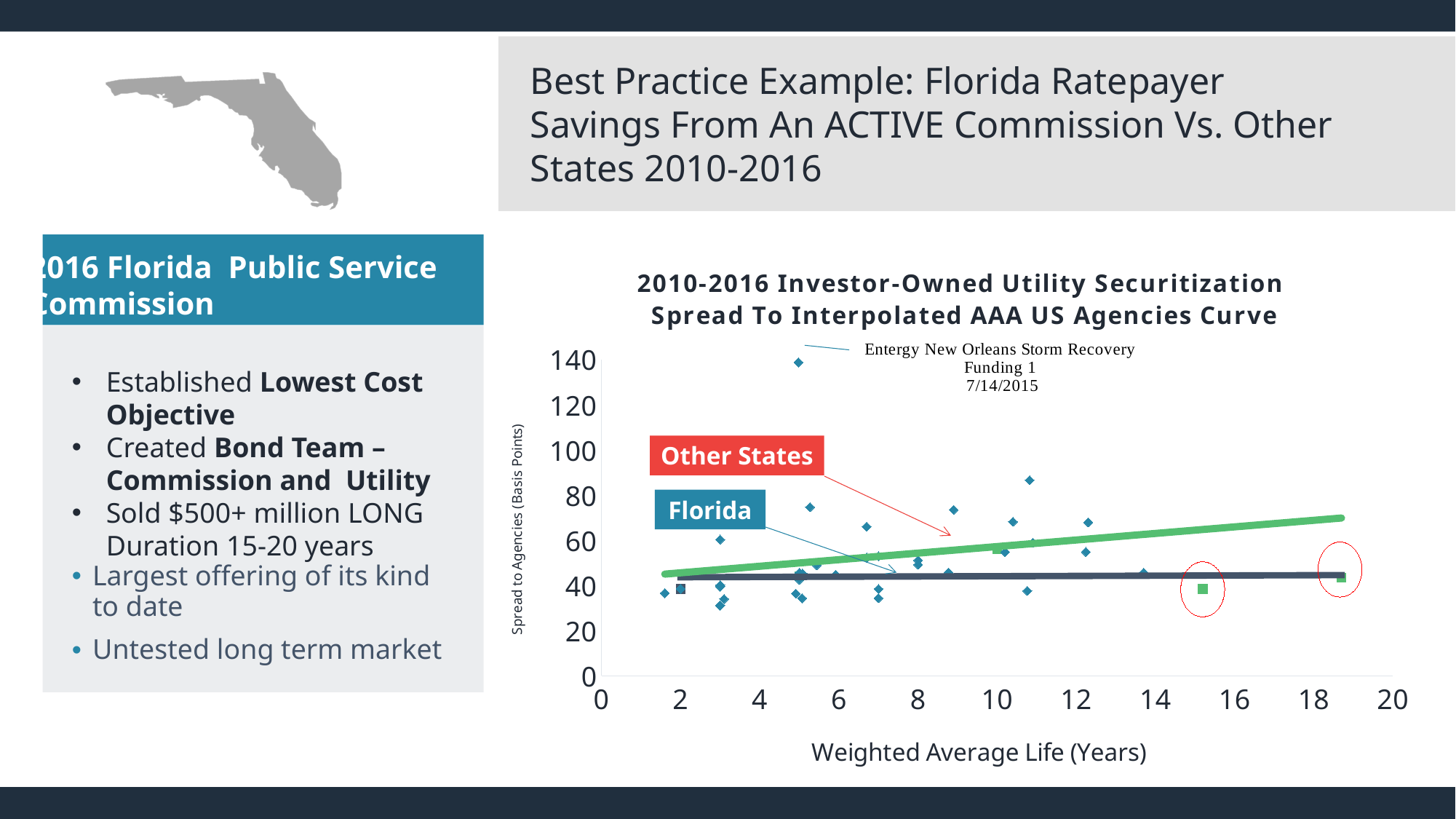
What is the highest value shown on the y axis? 140 Which issuance is annotated as the highest point on the chart? Entergy New Orleans Storm Recovery Funding 1 (7/14/2015) Is the spread for the circled Florida point near 15 years weighted average life greater or less than 60 basis points? less How many series are labeled on the chart? 2 At 18 years weighted average life, which trend line is higher, Other States or Florida? Other States Which series contains the highest plotted point on the chart? Other States Does the Other States trend line rise or fall as weighted average life increases? rises Is the spread for the circled Florida point near 19 years weighted average life greater or less than 60 basis points? less What kind of chart is shown on the slide? scatter chart Is the Other States point near 11 years weighted average life greater or less than 80 basis points? greater What is the title of the chart? 2010-2016 Investor-Owned Utility Securitization Spread To Interpolated AAA US Agencies Curve